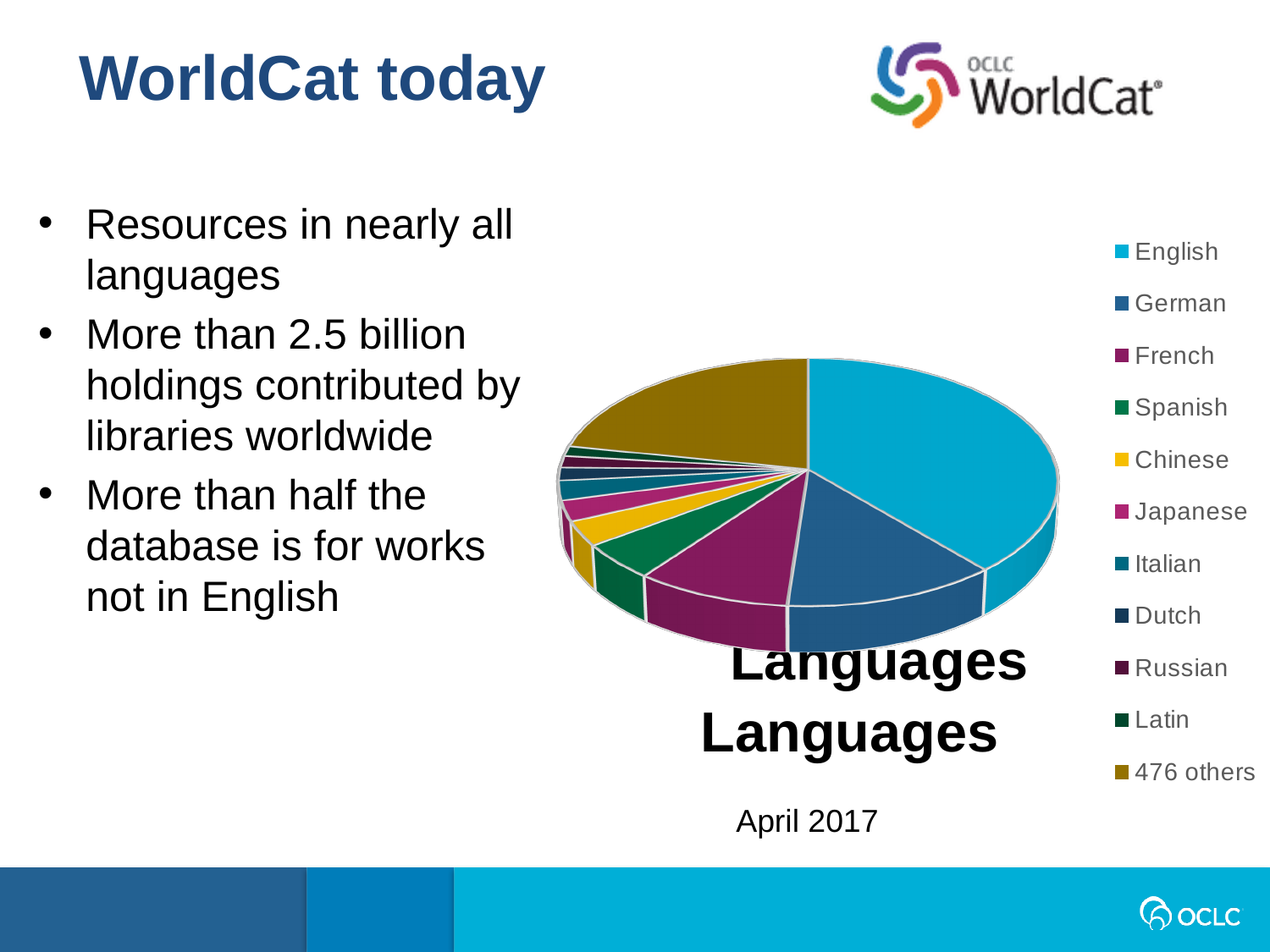
In the Languages pie chart, which slice is larger, English or German? English In the Languages pie chart, which slice is larger, French or Chinese? French Which language has the largest slice in the Languages pie chart? English In the Languages pie chart, which slice is larger, German or Latin? German What is the title of the pie chart on the slide? Languages What kind of chart is shown on the slide? pie chart What date is shown beneath the Languages pie chart? April 2017 How many categories does the legend of the Languages pie chart list? 11